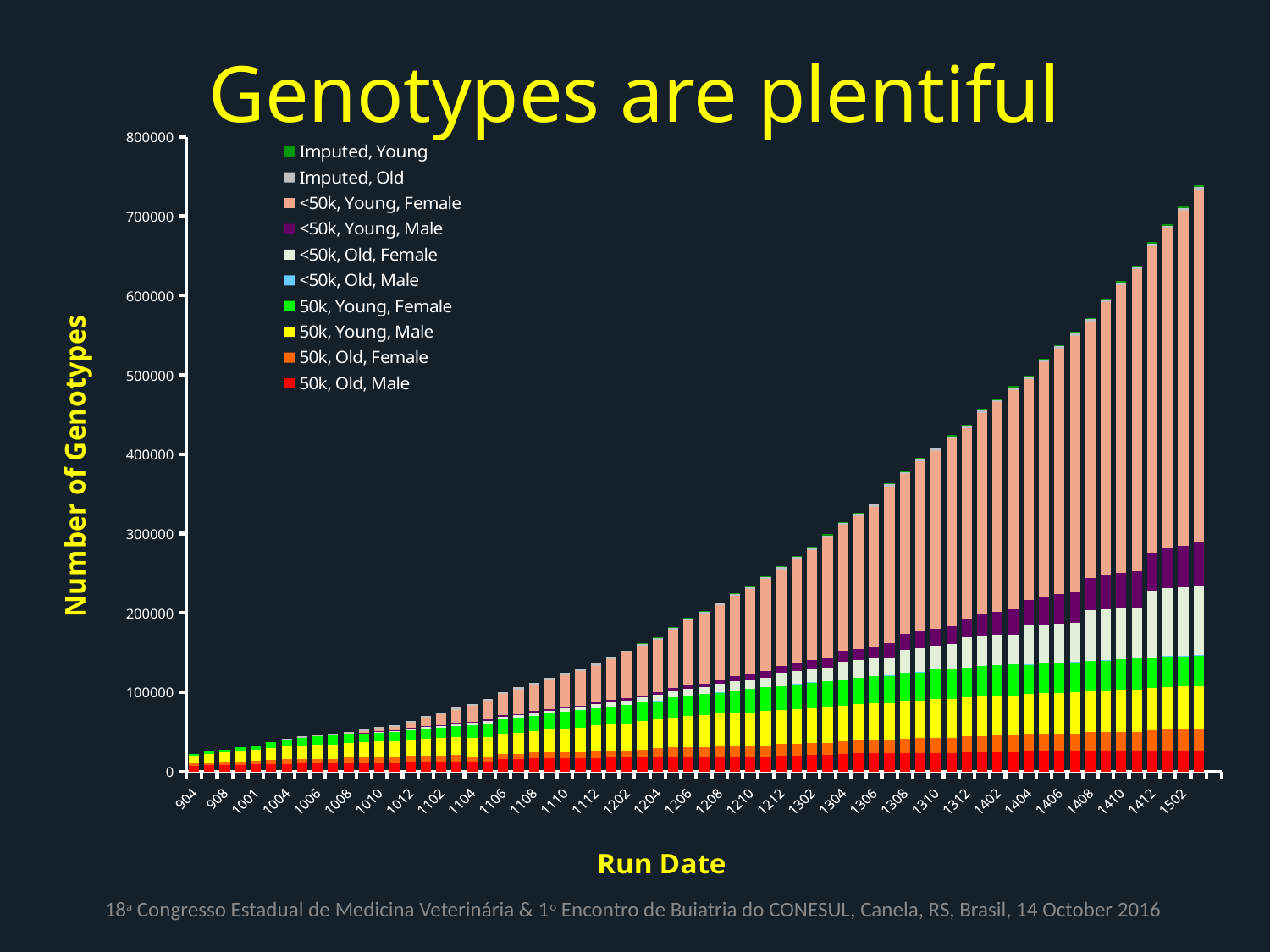
Do the total number of genotypes rise or fall as the run date moves from left to right? rise Is the total number of genotypes for run date 1004 greater or less than 100000? less Is the total number of genotypes for run date 904 greater or less than 100000? less Which run date has a larger total number of genotypes, 1308 or 1108? 1308 What kind of chart is shown on the slide? stacked bar chart Which run date has a larger total number of genotypes, 904 or 1502? 1502 How many series does the legend list? 10 What is the title of the chart? Genotypes are plentiful Is the total number of genotypes for the rightmost bar greater or less than 700000? greater What is the label of the vertical axis? Number of Genotypes